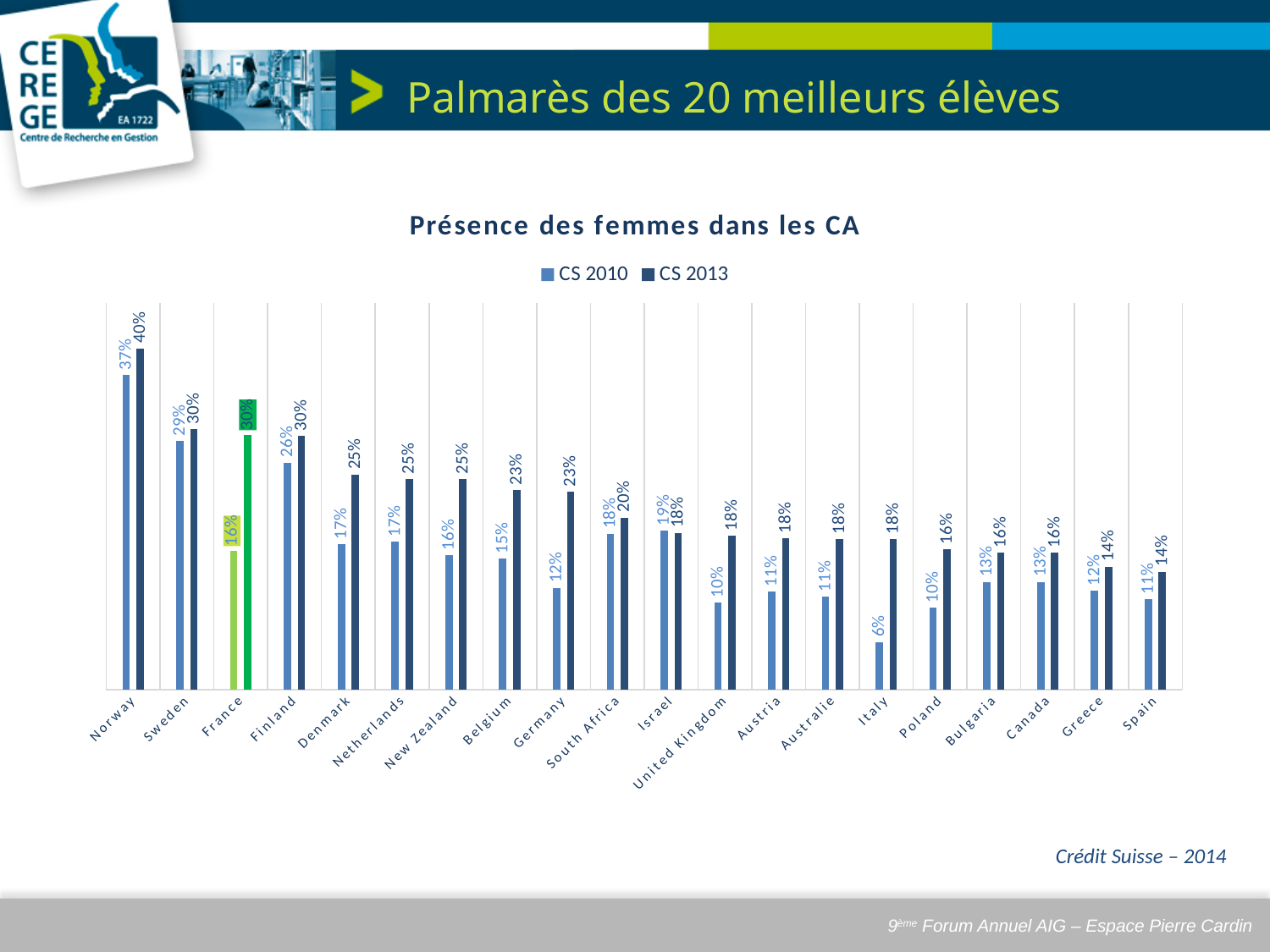
What is the difference between the CS 2013 values for Norway and Spain? 26% What is the CS 2010 value for Italy? 6% Which country has the highest CS 2013 value? Norway What is the CS 2013 value for Germany? 23% What is the CS 2013 value for France? 30% What is the title of the chart? Présence des femmes dans les CA How many countries are shown on the x axis? 20 What is the difference between the CS 2013 and CS 2010 values for France? 14% Which country has the lowest CS 2010 value? Italy Which is larger for Israel, the CS 2010 value or the CS 2013 value? CS 2010 How many series does the legend list? 2 What kind of chart is shown on the slide? Bar chart